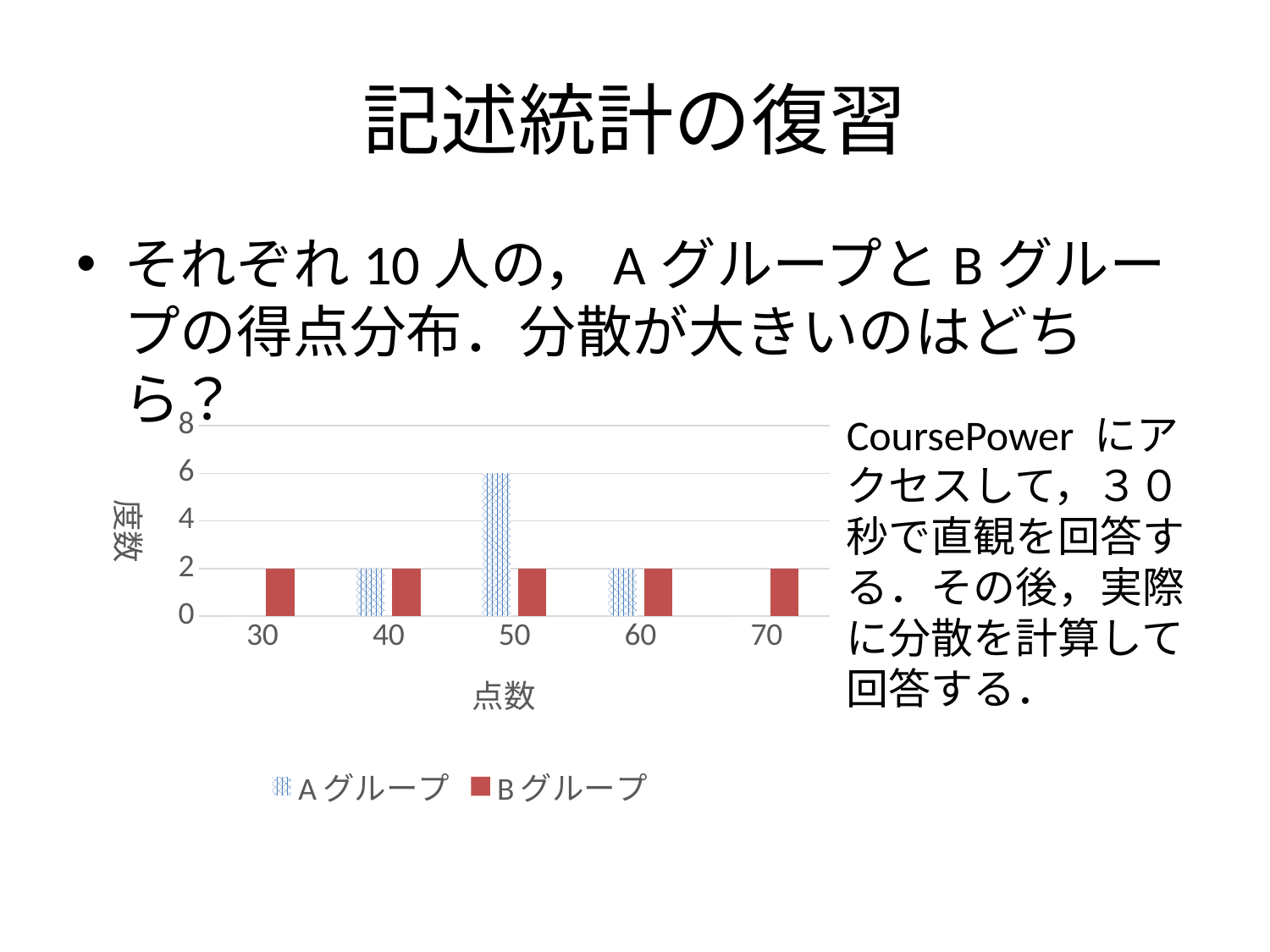
What kind of chart is shown on the slide? bar chart What is the difference between the frequencies of A グループ and B グループ at a score of 50? 4 What is the frequency (度数) for B グループ at a score of 70? 2 At a score of 50, which group has the larger frequency, A グループ or B グループ? A グループ How many score categories are shown on the x axis? 5 What are the two entries in the legend? A グループ, B グループ What is the title of the x axis? 点数 At which score does A グループ have its highest frequency? 50 Is the frequency for A グループ at a score of 50 greater or less than 4? greater What is the frequency (度数) for A グループ at a score of 50? 6 How many series does the legend list? 2 What is the frequency (度数) for A グループ at a score of 40? 2